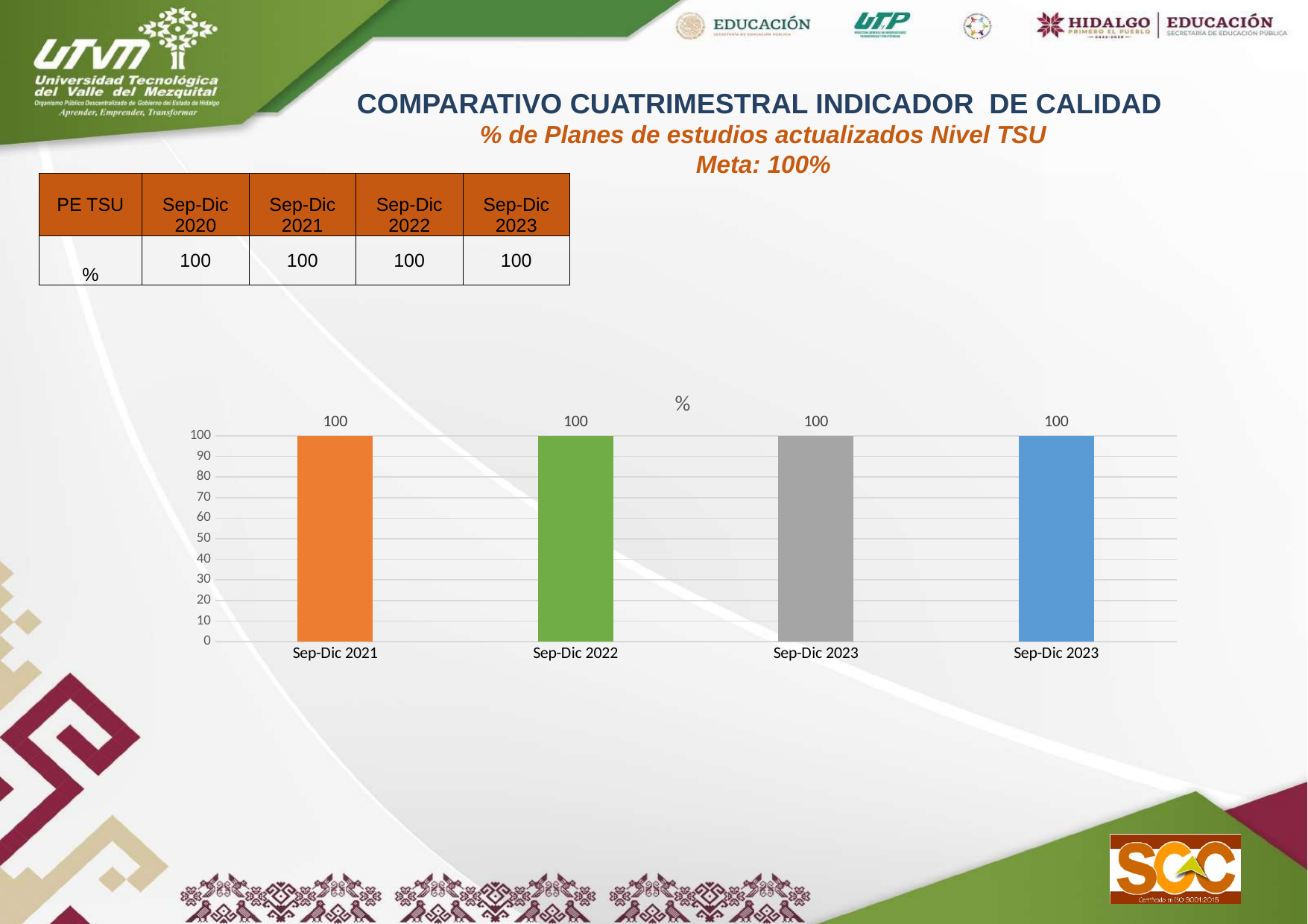
What colour is the bar for Sep-Dic 2021? orange What is the value for Sep-Dic 2021 in the chart? 100 What is the title of the chart? % How many bars are plotted in the chart? 4 Do the values rise, fall, or stay the same across the categories on the x axis? stay the same What kind of chart is shown on the slide? bar chart What value is shown above the blue bar in the chart? 100 Is the value for Sep-Dic 2021 larger than, smaller than, or equal to the value for Sep-Dic 2022? equal Is the value for Sep-Dic 2022 greater or less than 50? greater What value is shown above the gray bar in the chart? 100 What is the value for Sep-Dic 2022 in the chart? 100 What is the difference between the values for Sep-Dic 2021 and Sep-Dic 2022? 0